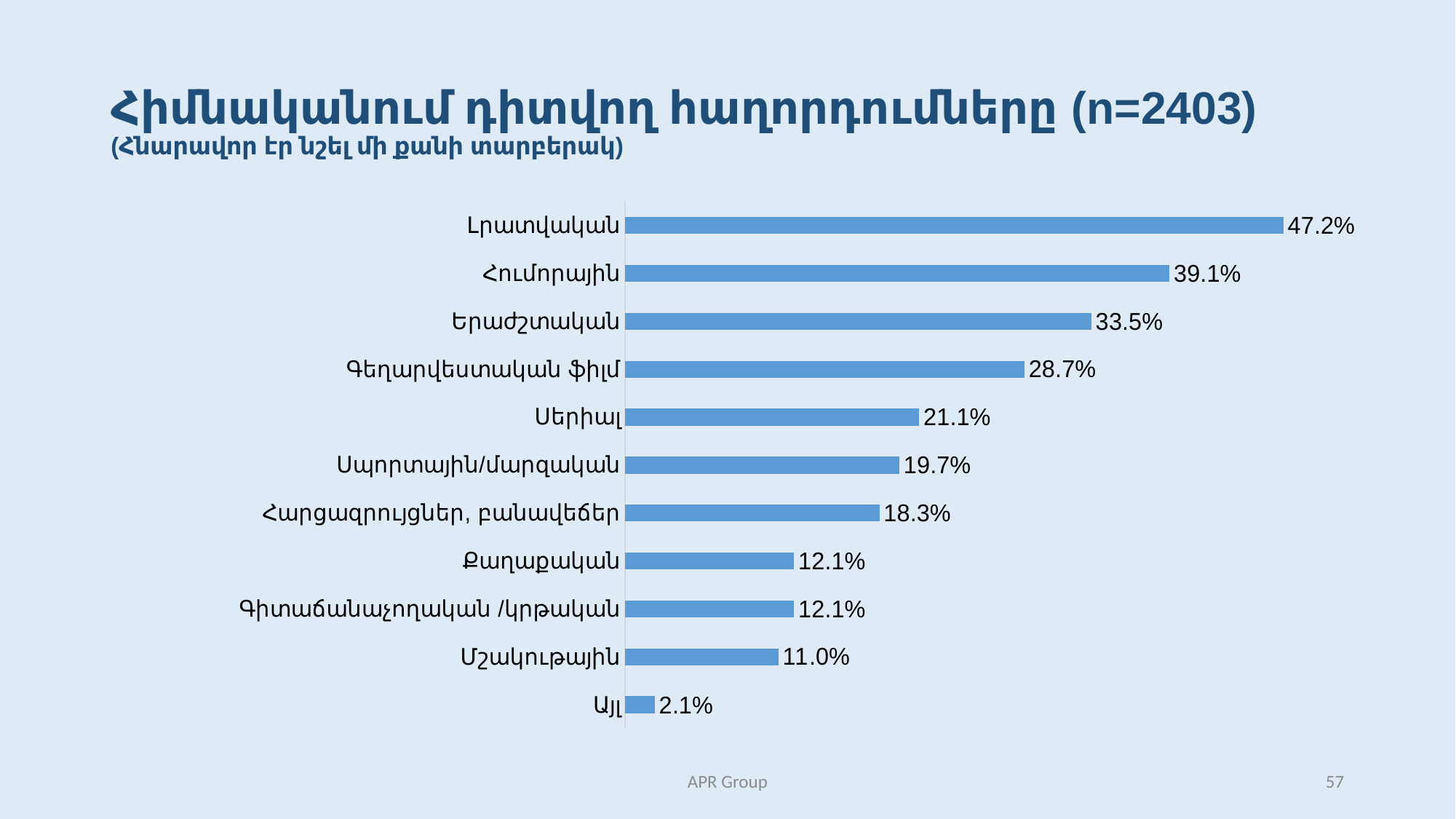
What is the difference between the values for Երաժշտական and Գեղարվեստական ֆիլմ? 4.8% How many categories are shown in the chart? 11 Which category has the lowest value? Այլ What is the value for Լրատվական? 47.2% Which is larger, the value for Սպորտային/մարզական or the value for Հարցազրույցներ, բանավեճեր? Սպորտային/մարզական What is the difference between the values for Լրատվական and Հումորային? 8.1% What is the value for Մշակութային? 11.0% Which category has the highest value? Լրատվական Which two categories share the same value of 12.1%? Քաղաքական and Գիտաճանաչողական /կրթական What is the value for Սերիալ? 21.1% What kind of chart is shown on the slide? Bar chart What is the sample size (n) stated in the chart title? 2403